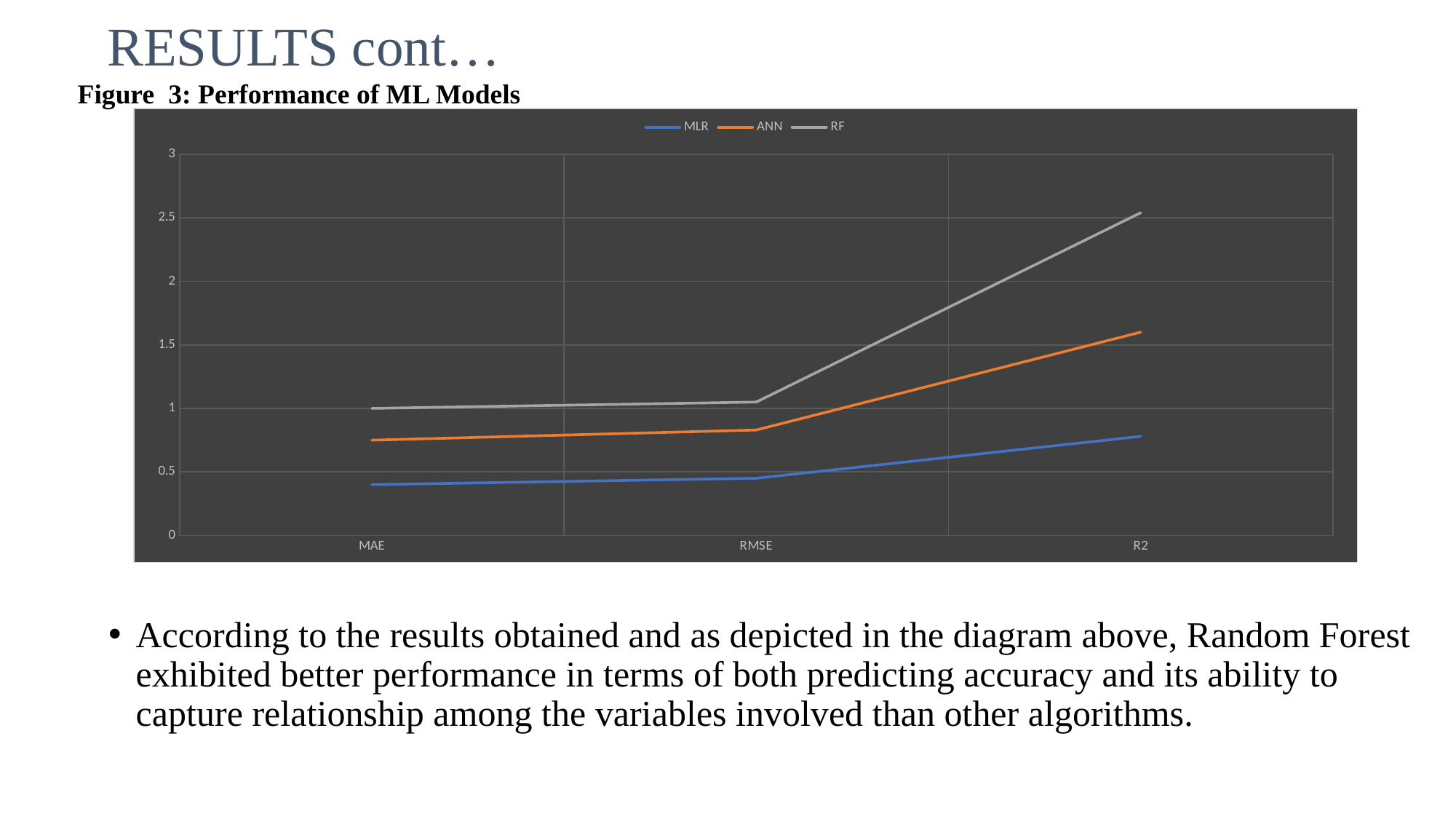
How many series does the legend list? 3 What is the title of the figure shown on the slide? Figure 3: Performance of ML Models Do the values of the RF series rise or fall from MAE to R2? rise How many categories are shown on the x axis? 3 Which series has the highest value at R2? RF Is the value for RF at R2 greater or less than 2? greater Is the value for MLR at MAE greater or less than 0.5? less For the RF series, which category has the highest value? R2 Which series has the lowest value at MAE? MLR What kind of chart is shown on the slide? line chart Is the value for ANN at R2 greater or less than 1.5? greater At RMSE, which is larger: the ANN value or the MLR value? ANN